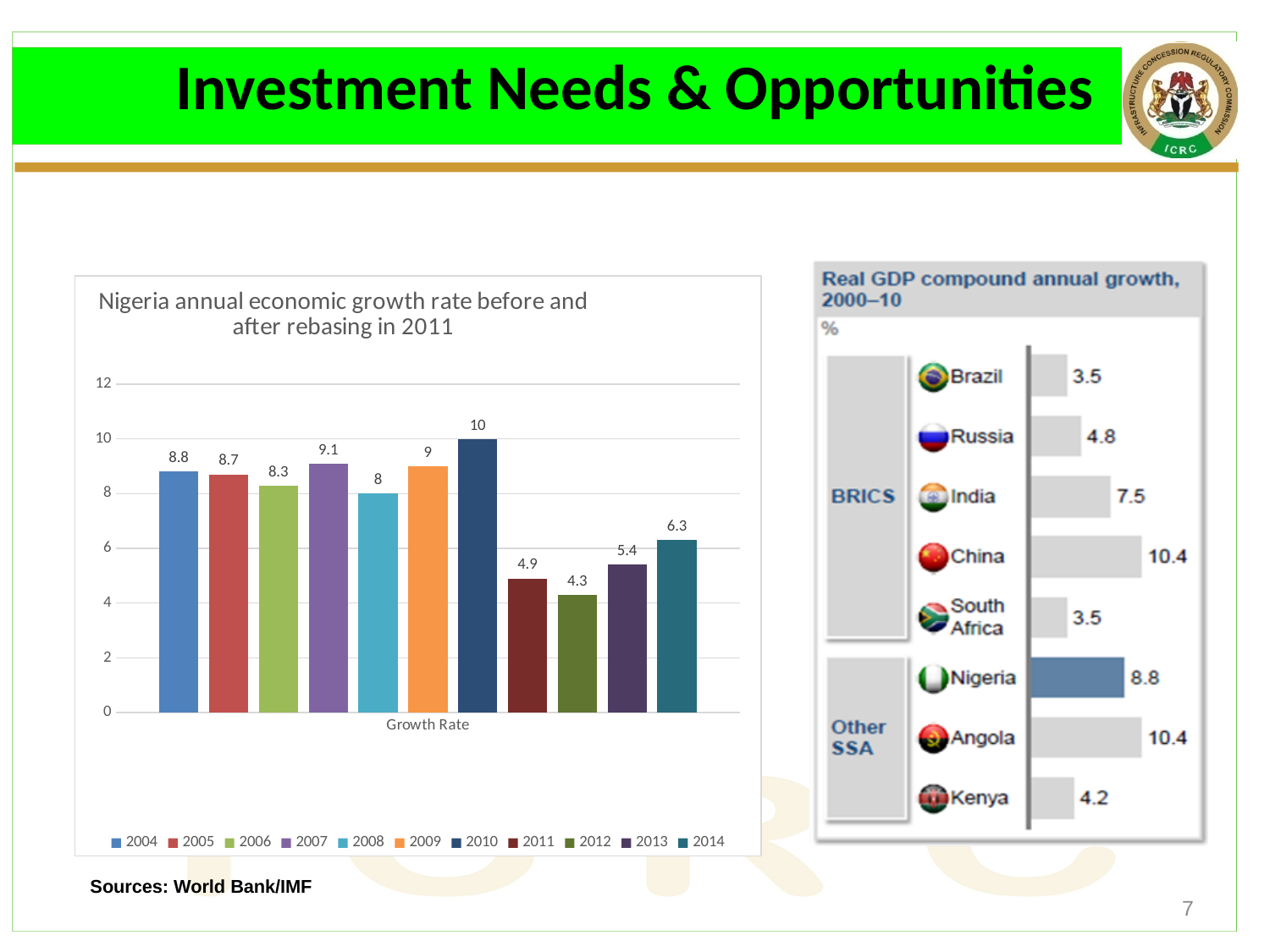
In the chart titled 'Real GDP compound annual growth, 2000–10', what is the value for India? 7.5 In the chart titled 'Nigeria annual economic growth rate before and after rebasing in 2011', how many years does the legend list? 11 In the chart titled 'Nigeria annual economic growth rate before and after rebasing in 2011', is the growth rate for 2014 greater or less than 8? less What kind of chart is the chart titled 'Real GDP compound annual growth, 2000–10'? bar chart In the chart titled 'Nigeria annual economic growth rate before and after rebasing in 2011', what is the difference between the 2010 and 2011 growth rates? 5.1 In the chart titled 'Nigeria annual economic growth rate before and after rebasing in 2011', what is the growth rate for 2012? 4.3 In the chart titled 'Real GDP compound annual growth, 2000–10', which is larger, the value for Russia or the value for Kenya? Russia In the chart titled 'Nigeria annual economic growth rate before and after rebasing in 2011', which year has the highest growth rate? 2010 In the chart titled 'Real GDP compound annual growth, 2000–10', what is the value for Nigeria? 8.8 In the chart titled 'Nigeria annual economic growth rate before and after rebasing in 2011', which year has the lowest growth rate? 2012 In the chart titled 'Nigeria annual economic growth rate before and after rebasing in 2011', what is the growth rate for 2010? 10 In the chart titled 'Real GDP compound annual growth, 2000–10', how many countries are shown? 8